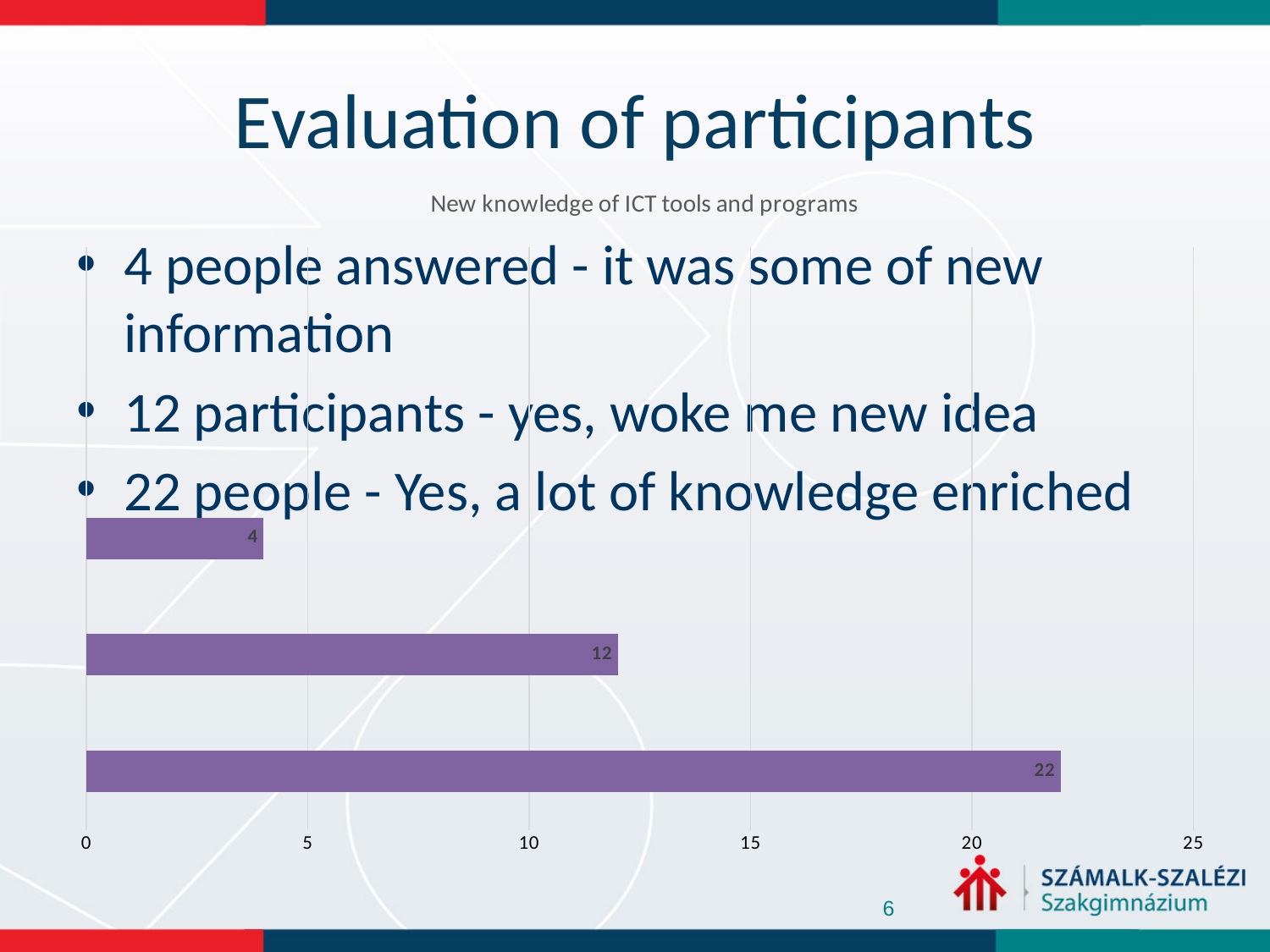
What is the title of the chart? New knowledge of ICT tools and programs What is the difference between the bottom bar and the middle bar? 10 What is the value of the top bar in the chart? 4 Which is larger, the middle bar or the top bar? the middle bar How many bars does the chart have? 3 What is the value of the bottom bar in the chart? 22 What is the maximum value shown on the horizontal axis? 25 What is the highest value shown in the chart? 22 What is the lowest value shown in the chart? 4 What is the value of the middle bar in the chart? 12 What kind of chart is shown on the slide? bar chart What is the difference between the middle bar and the top bar? 8